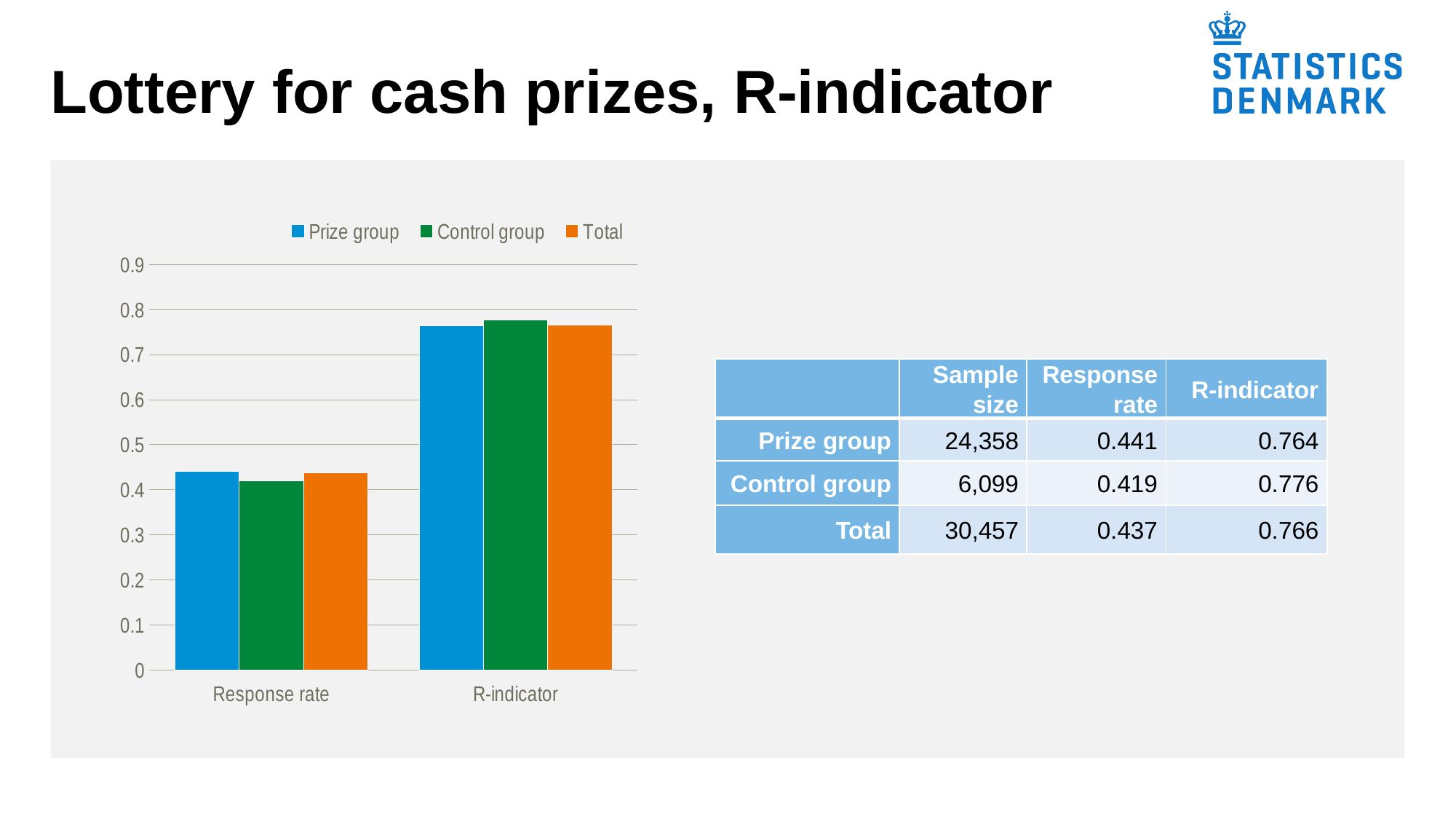
What is the Response rate value for Total? 0.437 How many series does the chart's legend list? 3 Is the Prize group value for Response rate greater or less than 0.5? less For the Response rate category, which series has the shortest bar? Control group What is the R-indicator value for the Prize group? 0.764 What kind of chart is shown on the slide? bar chart Is the Control group value for R-indicator greater or less than 0.7? greater What colour represents the Total series in the chart? orange For the R-indicator category, which series has the tallest bar? Control group What is the difference between the Control group and Prize group R-indicator values? 0.012 For the Total series, which is larger: the Response rate or the R-indicator? R-indicator How many categories are shown on the x axis of the chart? 2